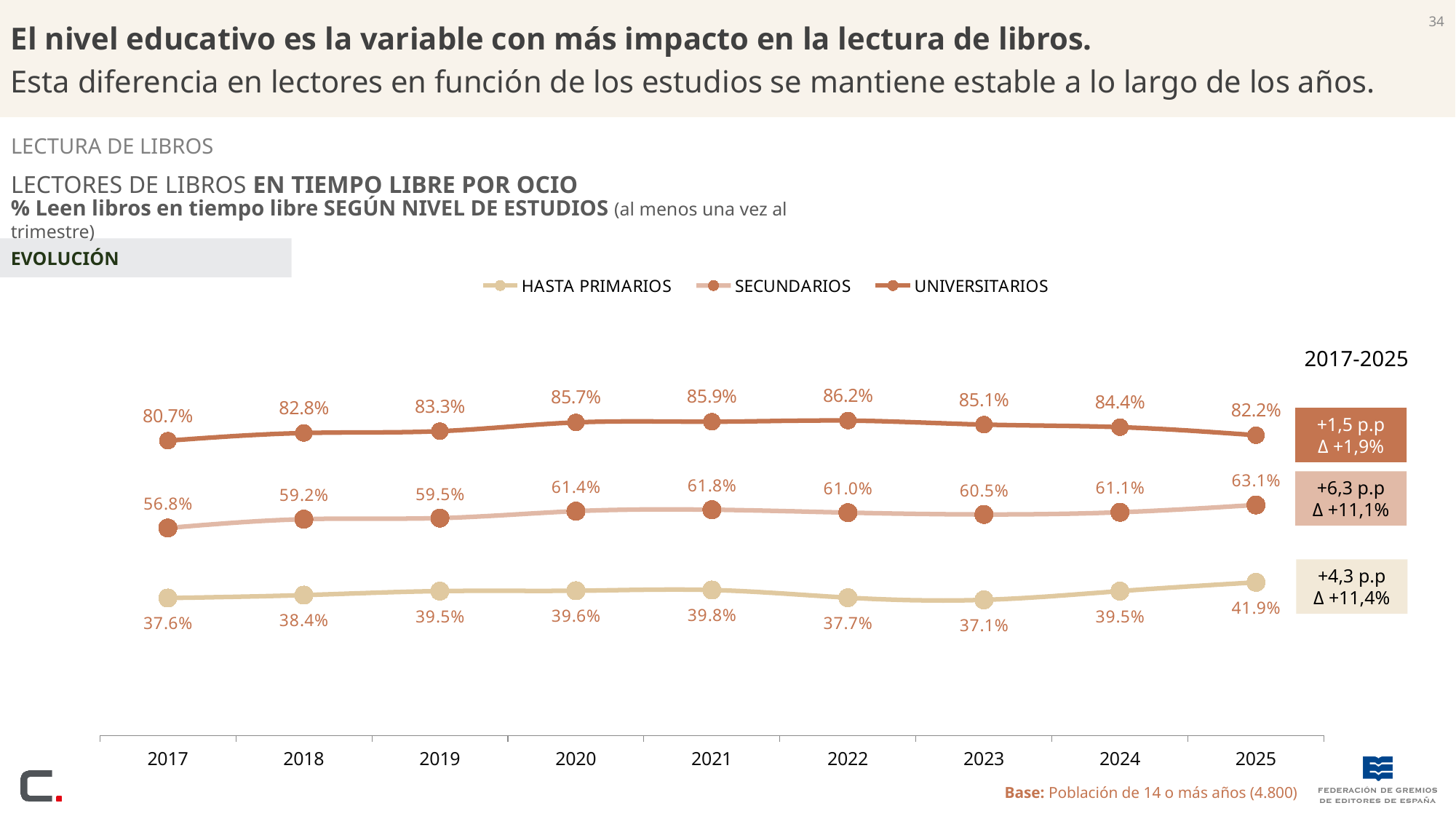
Which is larger, SECUNDARIOS in 2021 or SECUNDARIOS in 2023? SECUNDARIOS in 2021 What change in percentage points is shown for HASTA PRIMARIOS over 2017-2025? +4,3 p.p In which year is the HASTA PRIMARIOS series lowest? 2023 What kind of chart is shown on the slide? Line chart How many series does the legend list? 3 What is the value for SECUNDARIOS in 2025? 63.1% What is the value for UNIVERSITARIOS in 2022? 86.2% Does the SECUNDARIOS series rise or fall from 2017 to 2025? Rise How many years are shown on the x axis? 9 What is the value for HASTA PRIMARIOS in 2017? 37.6% What is the difference between UNIVERSITARIOS and HASTA PRIMARIOS in 2025? 40.3 percentage points In which year is the UNIVERSITARIOS series highest? 2022